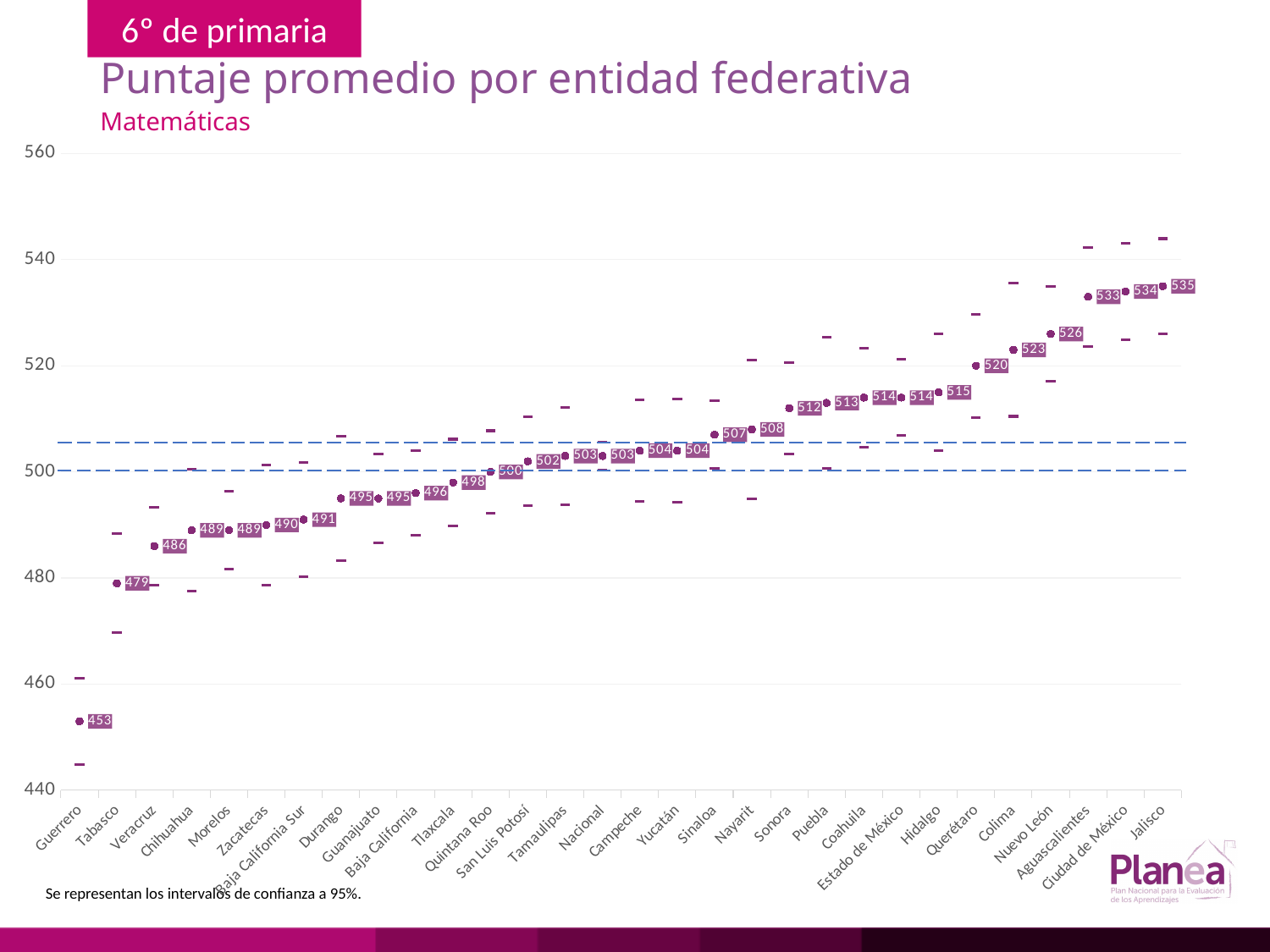
What is the value plotted for Nacional? 503 Which entity has the highest average score? Jalisco What is the average score for Querétaro? 520 What is the average mathematics score for Guerrero? 453 How many entities (categories) are plotted on the x axis? 30 What is the average score shown for Jalisco? 535 What subject is shown in the chart's subtitle? Matemáticas Do the plotted values rise or fall from left to right along the x axis? rise Which has a higher average score, Nuevo León or Colima? Nuevo León What is the difference between the scores of Jalisco and Guerrero? 82 Is the value for Tabasco greater or less than 480? less Which entity has the lowest average score? Guerrero